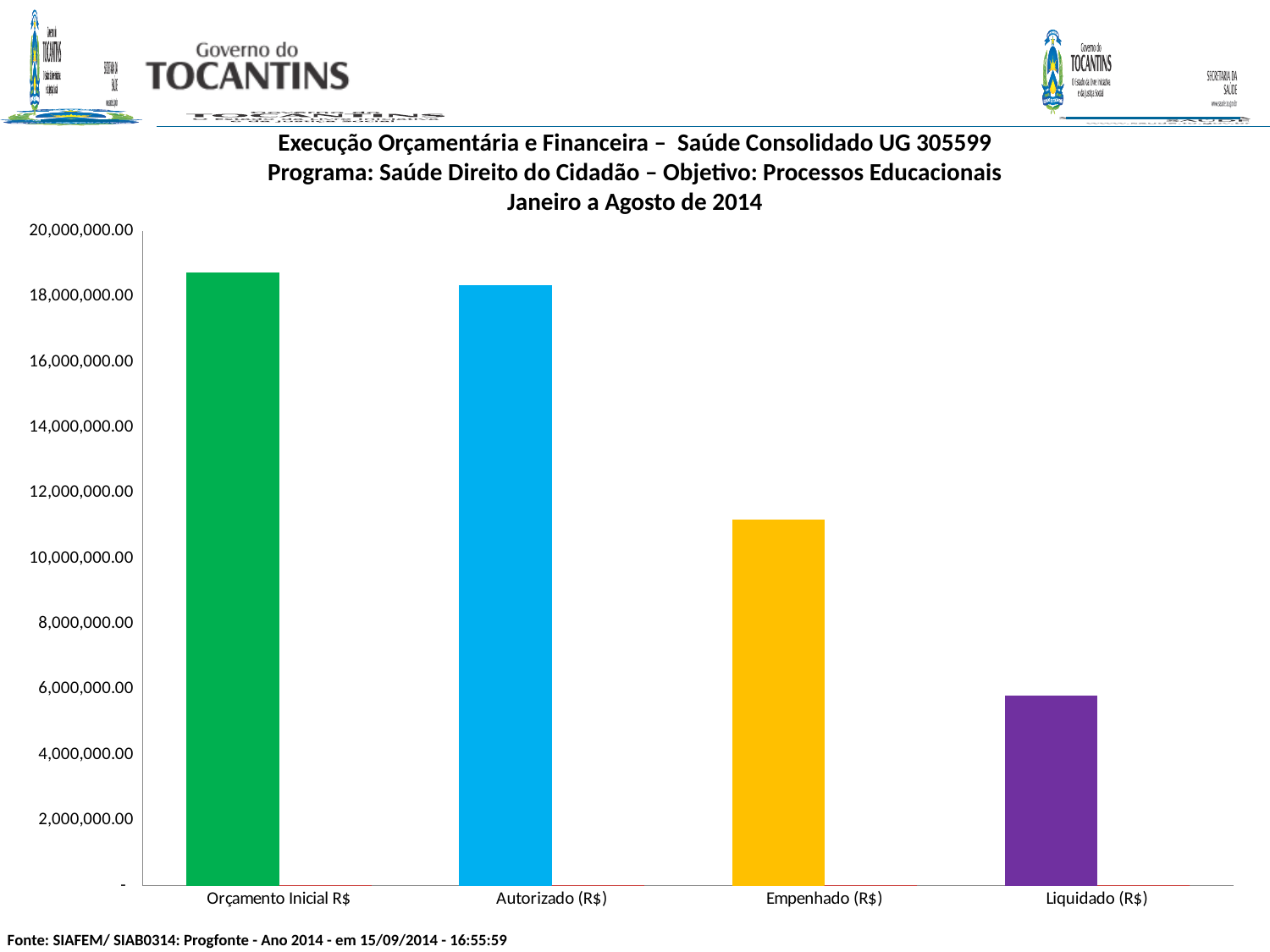
What period does the chart title say the data covers? Janeiro a Agosto de 2014 Which is larger, the value for Empenhado (R$) or the value for Liquidado (R$)? Empenhado (R$) Is the value for Orçamento Inicial R$ greater or less than 18,000,000.00? greater Is the value for Autorizado (R$) greater or less than 18,000,000.00? greater Is the value for Empenhado (R$) greater or less than 12,000,000.00? less What kind of chart is shown on the slide? bar chart How many categories are plotted on the chart? 4 Do the values rise or fall from left to right across the categories? fall Which is larger, the value for Autorizado (R$) or the value for Empenhado (R$)? Autorizado (R$) Which category has the lowest value? Liquidado (R$)